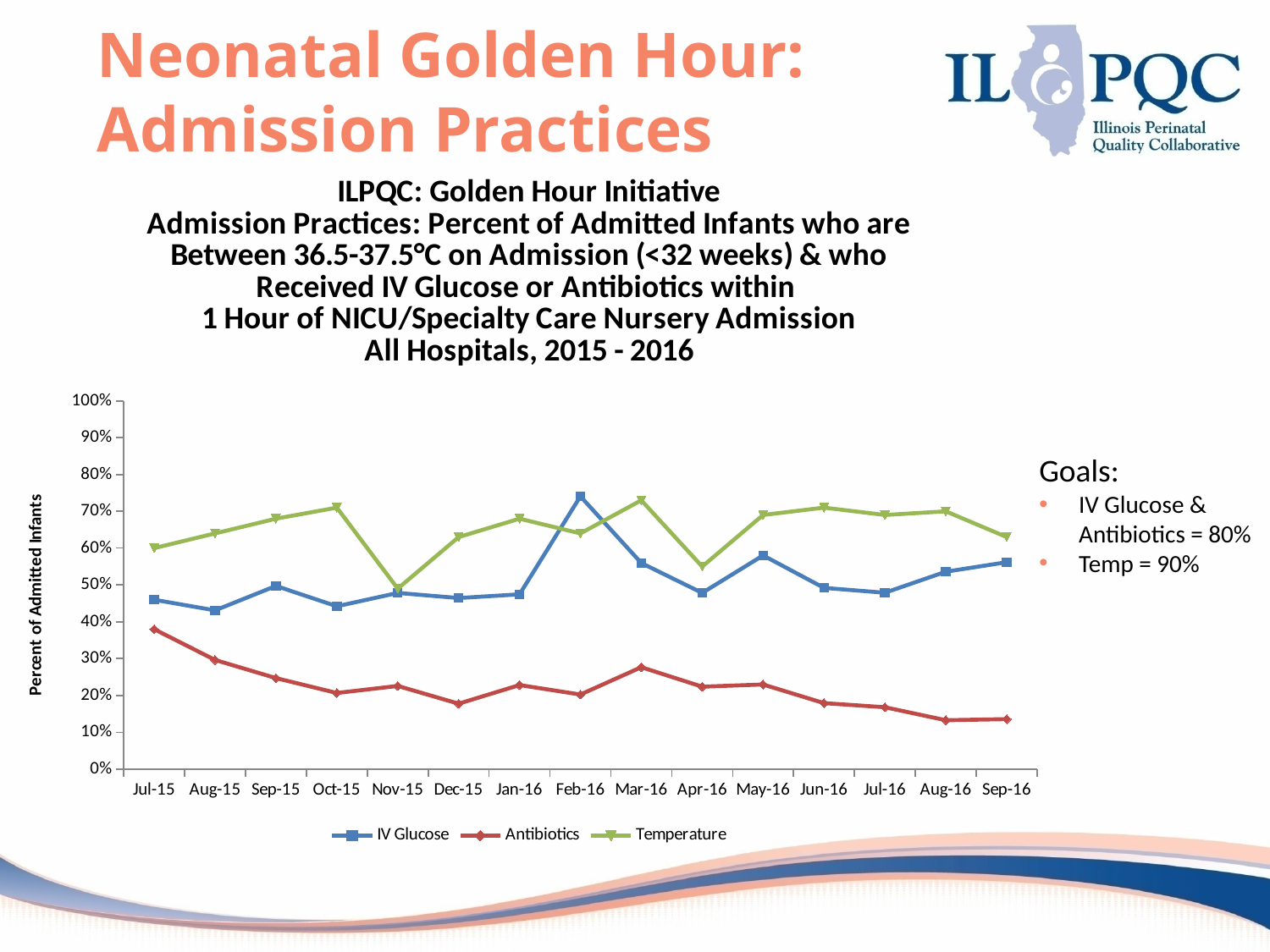
In which month is the Antibiotics series at its highest? Jul-15 How many series does the chart legend list? 3 In Feb-16, which series has the higher value, IV Glucose or Temperature? IV Glucose What kind of chart is shown on the slide? Line chart Is the Antibiotics value for Sep-16 greater or less than 20%? less Does the Antibiotics series generally rise or fall from Jul-15 to Sep-16? Fall Is the Temperature value for Nov-15 greater or less than 60%? less In which month does the IV Glucose series reach its highest value? Feb-16 Is the IV Glucose value for Feb-16 greater or less than 70%? greater How many months are plotted along the x axis of the chart? 15 According to the goals listed beside the chart, what is the goal for Temp? 90% In which month does the Temperature series reach its lowest value? Nov-15